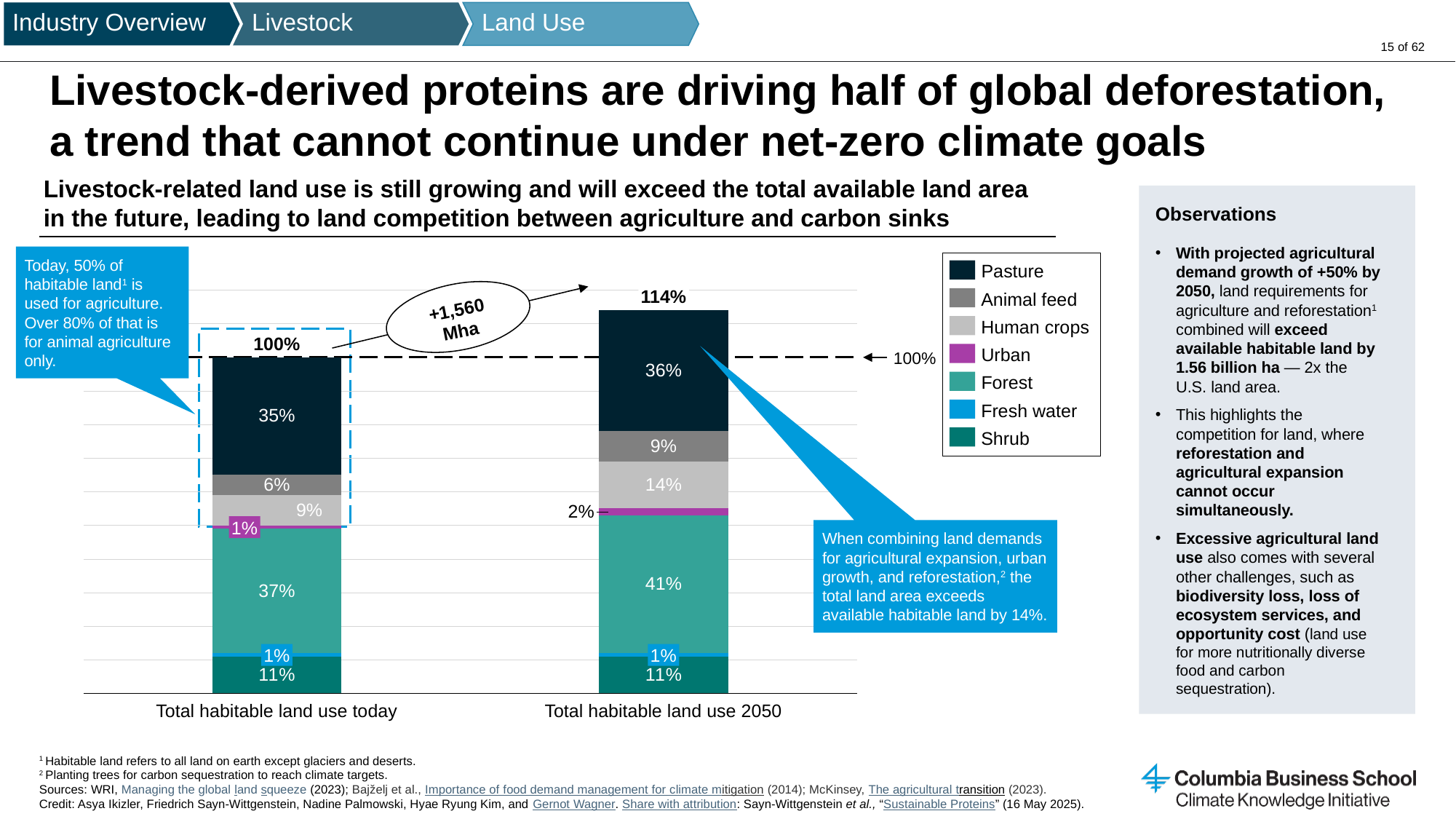
Which segment is the largest in the Total habitable land use 2050 bar? Forest How many series does the chart legend list? 7 Is the Animal feed share larger today or in 2050? 2050 What is the total of the Total habitable land use today bar? 100% What is the total of the Total habitable land use 2050 bar? 114% Which series is shown in the darkest colour at the top of each bar? Pasture What is the Forest share for Total habitable land use 2050? 41% How many bars (categories) are plotted in the chart? 2 What is the Human crops share for Total habitable land use 2050? 14% What kind of chart is shown on the slide? Stacked bar chart What is the difference between the Human crops share in 2050 and today? 5% What is the Pasture share for Total habitable land use today? 35%